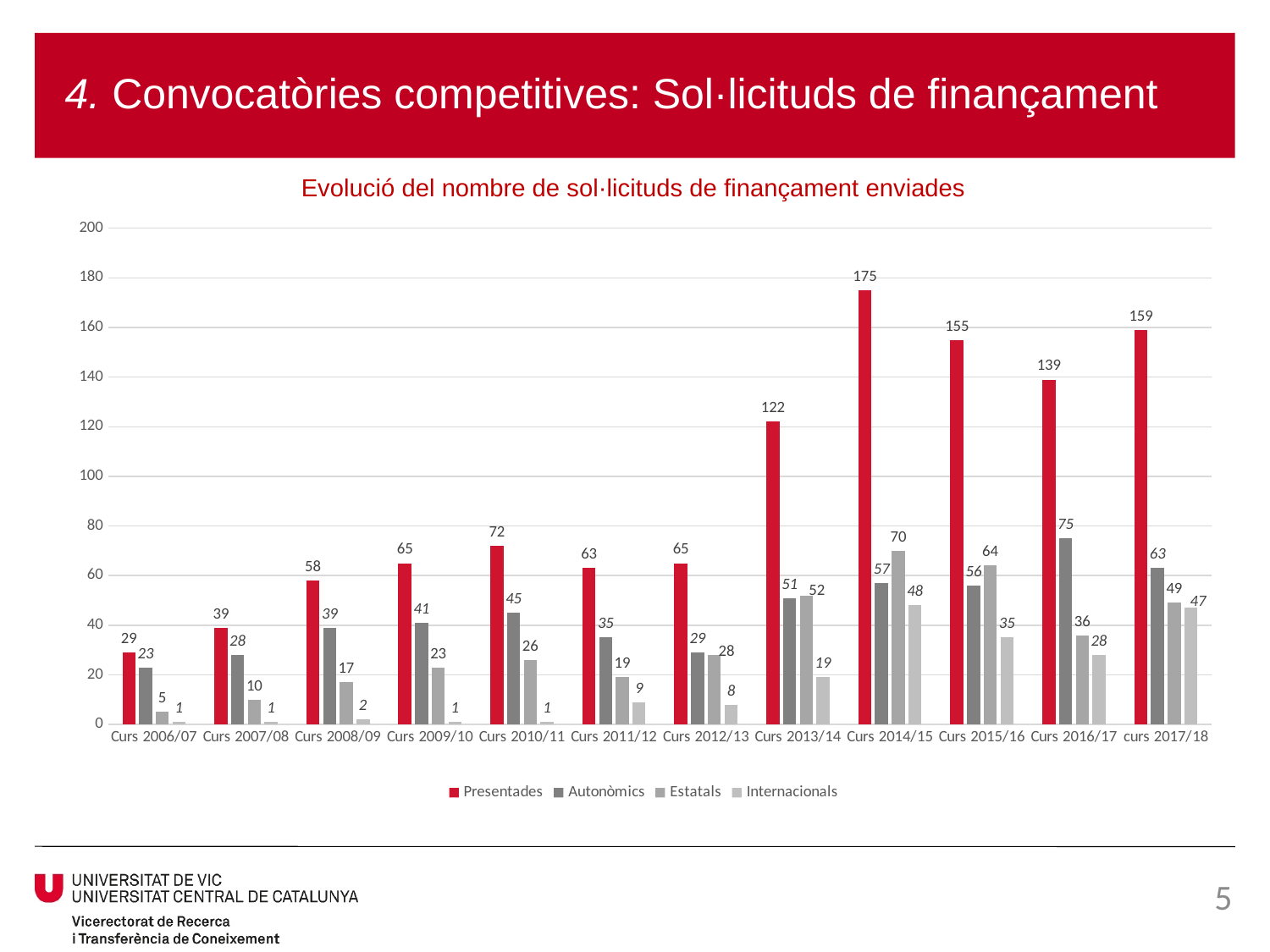
How many series does the legend list? 4 Is the Presentades value for Curs 2016/17 greater or less than 120? greater What is the value of Presentades for Curs 2014/15? 175 How many academic years are shown on the x axis? 12 For Curs 2013/14, which is larger: Autonòmics or Estatals? Estatals What is the value of Autonòmics for Curs 2016/17? 75 Which academic year has the lowest Presentades value? Curs 2006/07 What is the title of the chart? Evolució del nombre de sol·licituds de finançament enviades What is the value of Internacionals for curs 2017/18? 47 What is the difference between the Presentades values for Curs 2014/15 and Curs 2015/16? 20 Which academic year has the highest Presentades value? Curs 2014/15 What kind of chart is shown on the slide? Bar chart